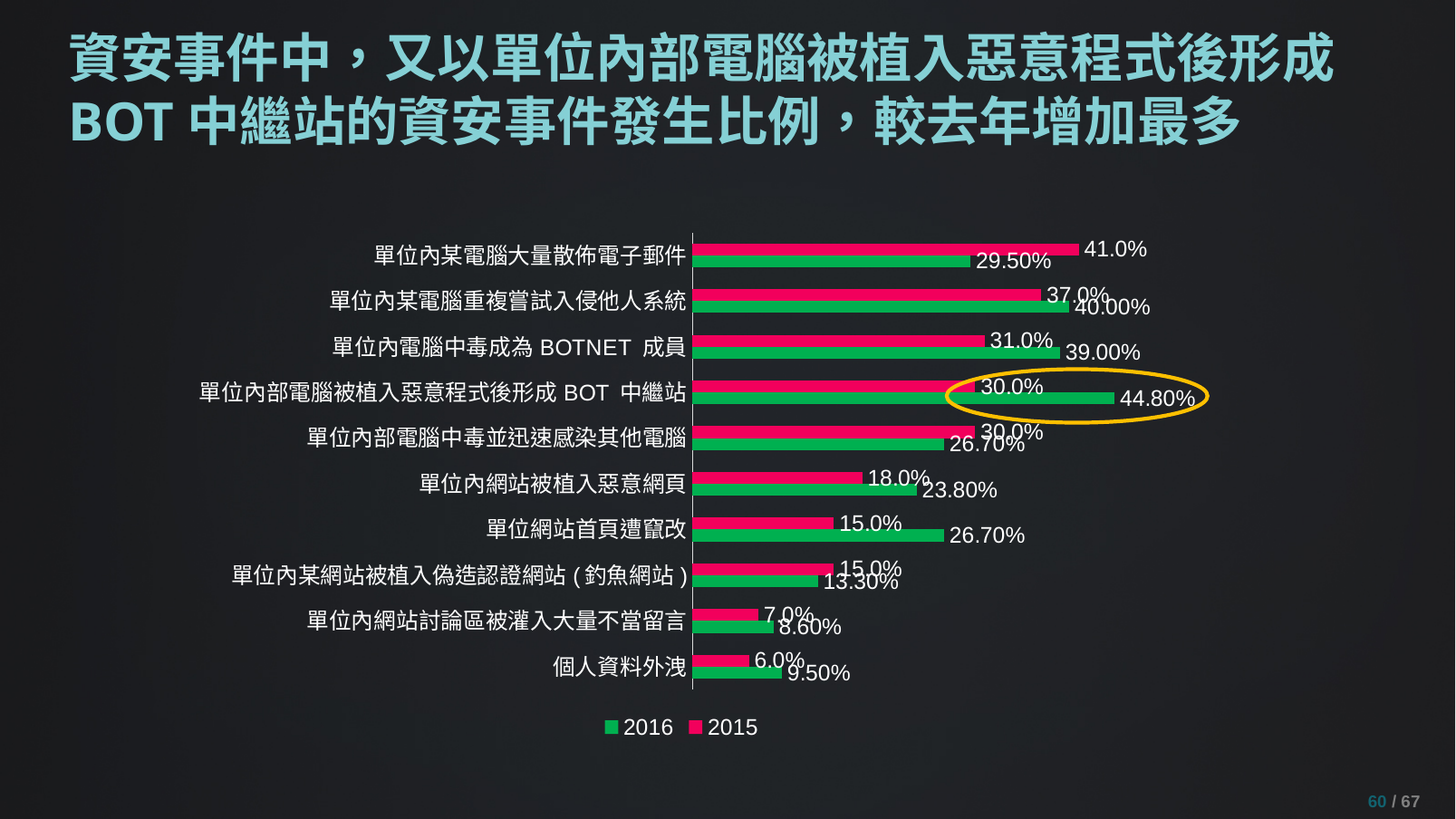
Which category has the highest 2016 value? 單位內部電腦被植入惡意程式後形成 BOT 中繼站 What is the difference between the 2015 and 2016 values for 單位內某電腦大量散佈電子郵件? 11.5% What kind of chart is shown on the slide? Bar chart For 單位網站首頁遭竄改, which year has the larger value, 2015 or 2016? 2016 For 單位內某網站被植入偽造認證網站(釣魚網站), which year has the larger value, 2015 or 2016? 2015 What is the 2015 value for 單位內某電腦大量散佈電子郵件? 41.0% How many categories are shown in the chart? 10 How many series does the legend list? 2 What is the 2016 value for 個人資料外洩? 9.50% Which category has the lowest 2015 value? 個人資料外洩 What is the difference between the 2016 and 2015 values for 單位內部電腦被植入惡意程式後形成 BOT 中繼站? 14.80% What is the 2016 value for 單位內部電腦被植入惡意程式後形成 BOT 中繼站? 44.80%